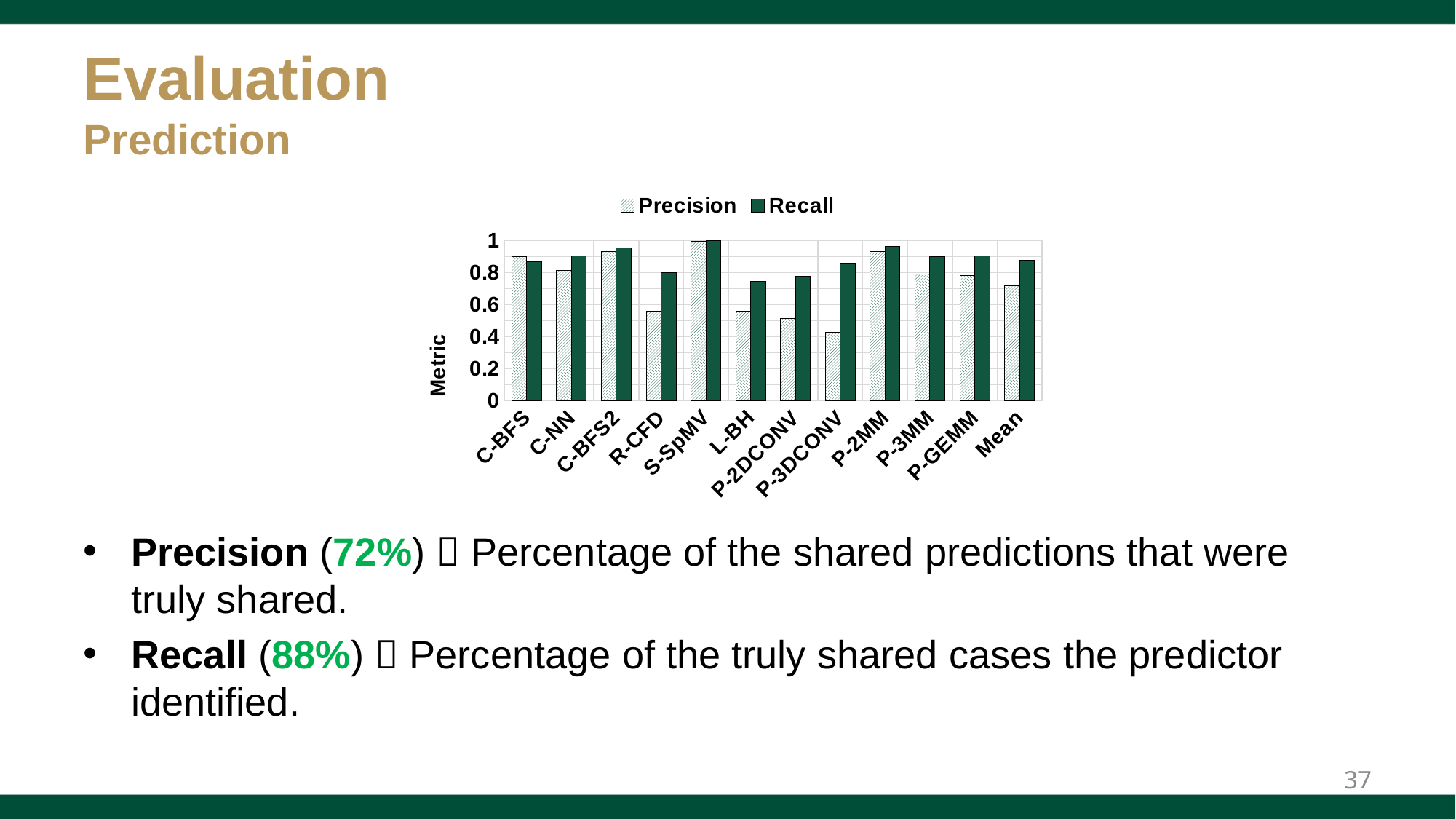
What is the label of the y axis? Metric Which category has the highest Precision value? S-SpMV Is the Precision value for P-3DCONV greater or less than 0.6? less Which category has the lowest Precision value? P-3DCONV What kind of chart is shown on the slide? bar chart For R-CFD, which is larger, Precision or Recall? Recall Is the Precision value for R-CFD greater or less than 0.8? less How many categories are shown on the x axis? 12 What are the two series named in the legend? Precision and Recall How many series does the legend list? 2 Is the Recall value for C-BFS2 greater or less than 0.8? greater